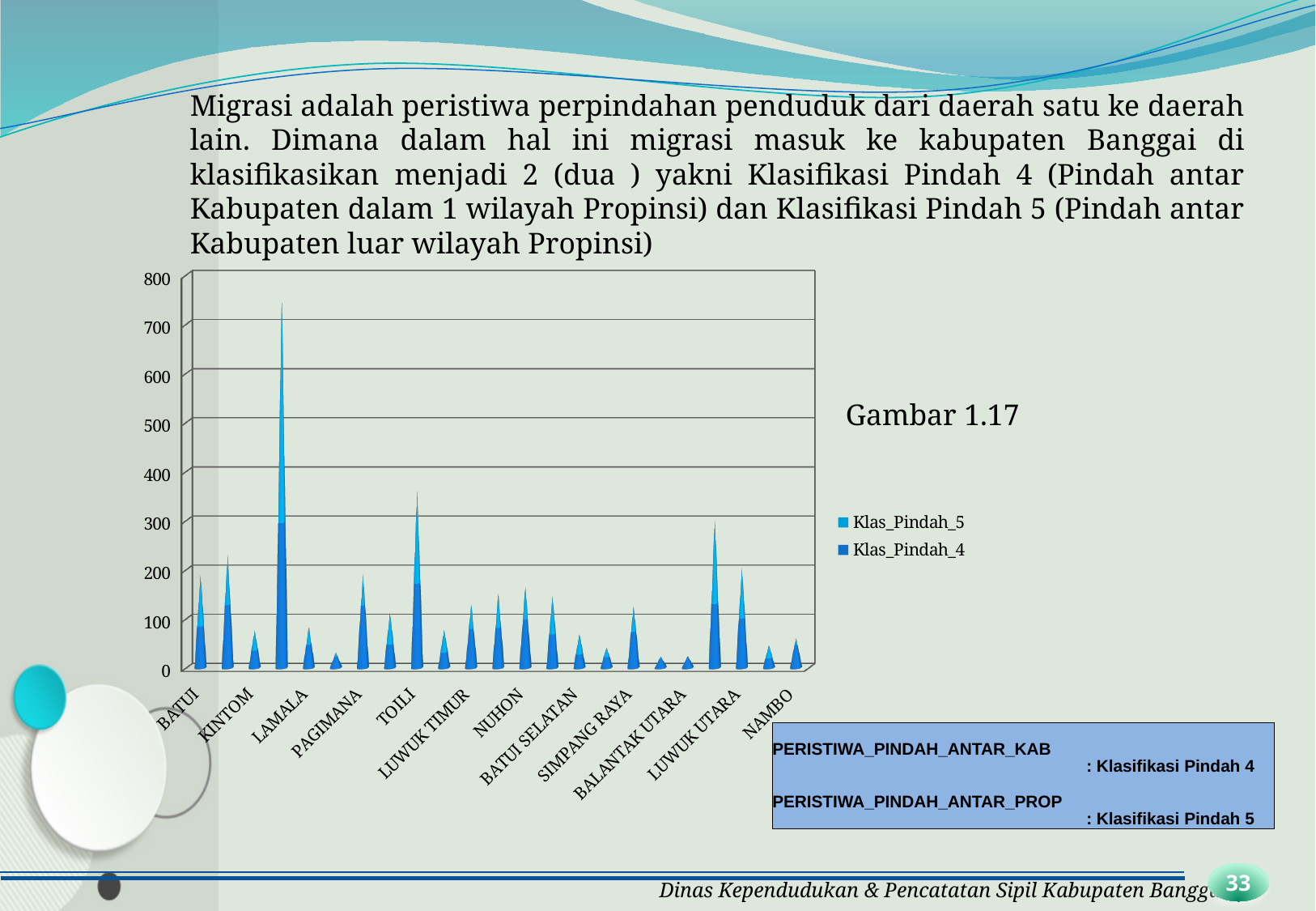
Is the total value for BATUI greater or less than 200? less Which has the larger total value, LAMALA or TOILI? TOILI What kind of chart is shown on the slide? bar chart How many series does the chart legend list? 2 What are the two series named in the chart legend? Klas_Pindah_5 and Klas_Pindah_4 Is the total value for PAGIMANA greater or less than 100? greater Is the total value for LAMALA greater or less than 600? less Which has the larger total value, TOILI or LUWUK UTARA? TOILI What figure label is given next to the chart? Gambar 1.17